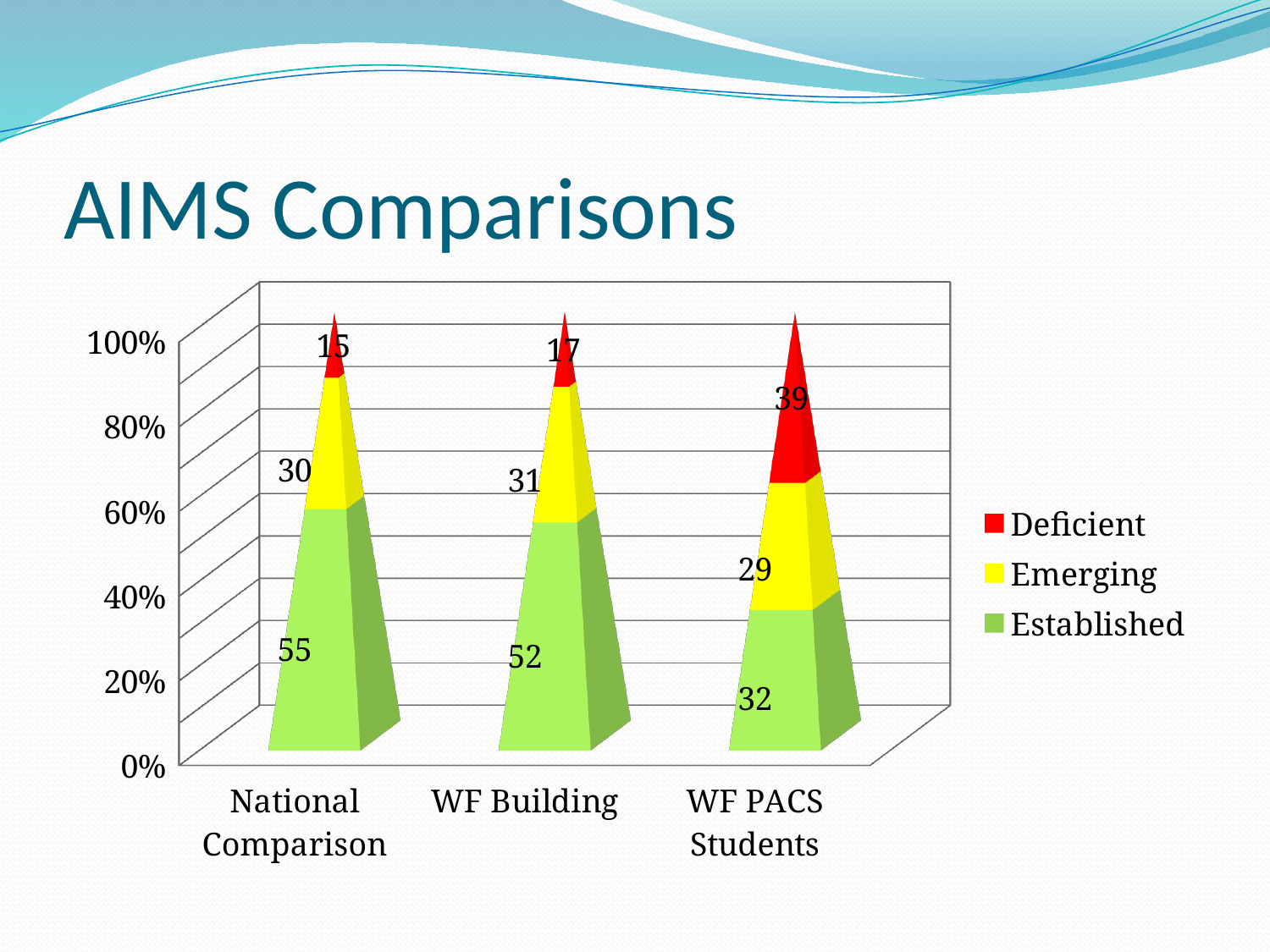
Which category has the lowest Established value? WF PACS Students What is the total of the stacked bar for WF Building? 100 Which is larger, the Deficient value for WF Building or for National Comparison? WF Building Which category has the highest Deficient value? WF PACS Students What is the Established value for National Comparison? 55 What kind of chart is shown on the slide? Stacked bar chart How many categories are shown on the x axis? 3 What is the title of the slide? AIMS Comparisons What is the Emerging value for WF Building? 31 What is the Deficient value for WF PACS Students? 39 What is the difference between the Established values for National Comparison and WF PACS Students? 23 How many series does the legend list? 3